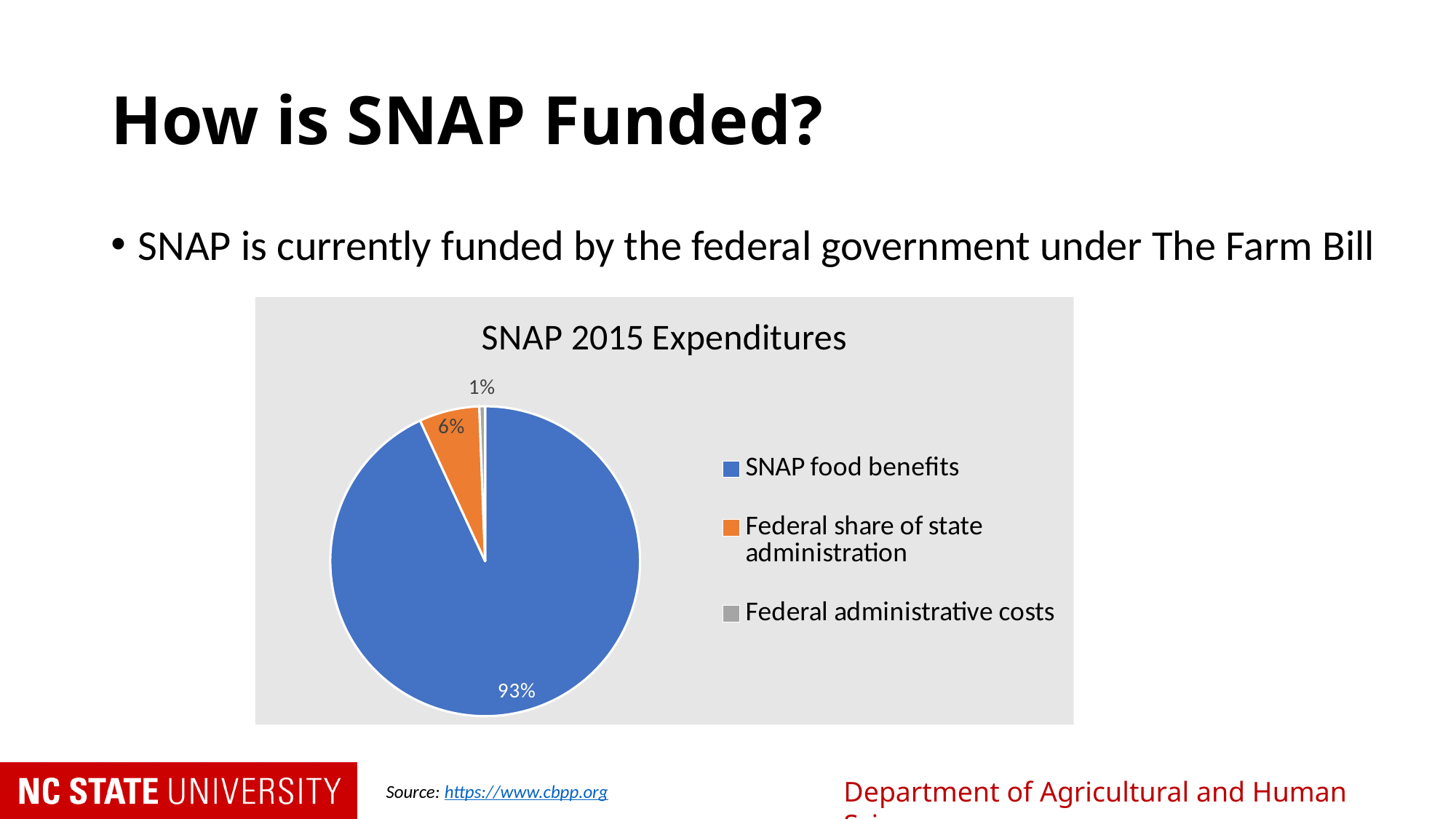
Which is larger, the Federal share of state administration or Federal administrative costs? Federal share of state administration Which category has the smallest slice of the pie? Federal administrative costs What type of chart is shown on the slide? pie chart Which category has the largest slice of the pie? SNAP food benefits What colour is the slice for SNAP food benefits? blue How many categories does the legend list? 3 What share of SNAP 2015 expenditures is SNAP food benefits? 93% What share of SNAP 2015 expenditures is the Federal share of state administration? 6% What share of SNAP 2015 expenditures is Federal administrative costs? 1% What is the title of the chart? SNAP 2015 Expenditures What is the difference in percentage points between SNAP food benefits and the Federal share of state administration? 87 What is the difference in percentage points between the Federal share of state administration and Federal administrative costs? 5